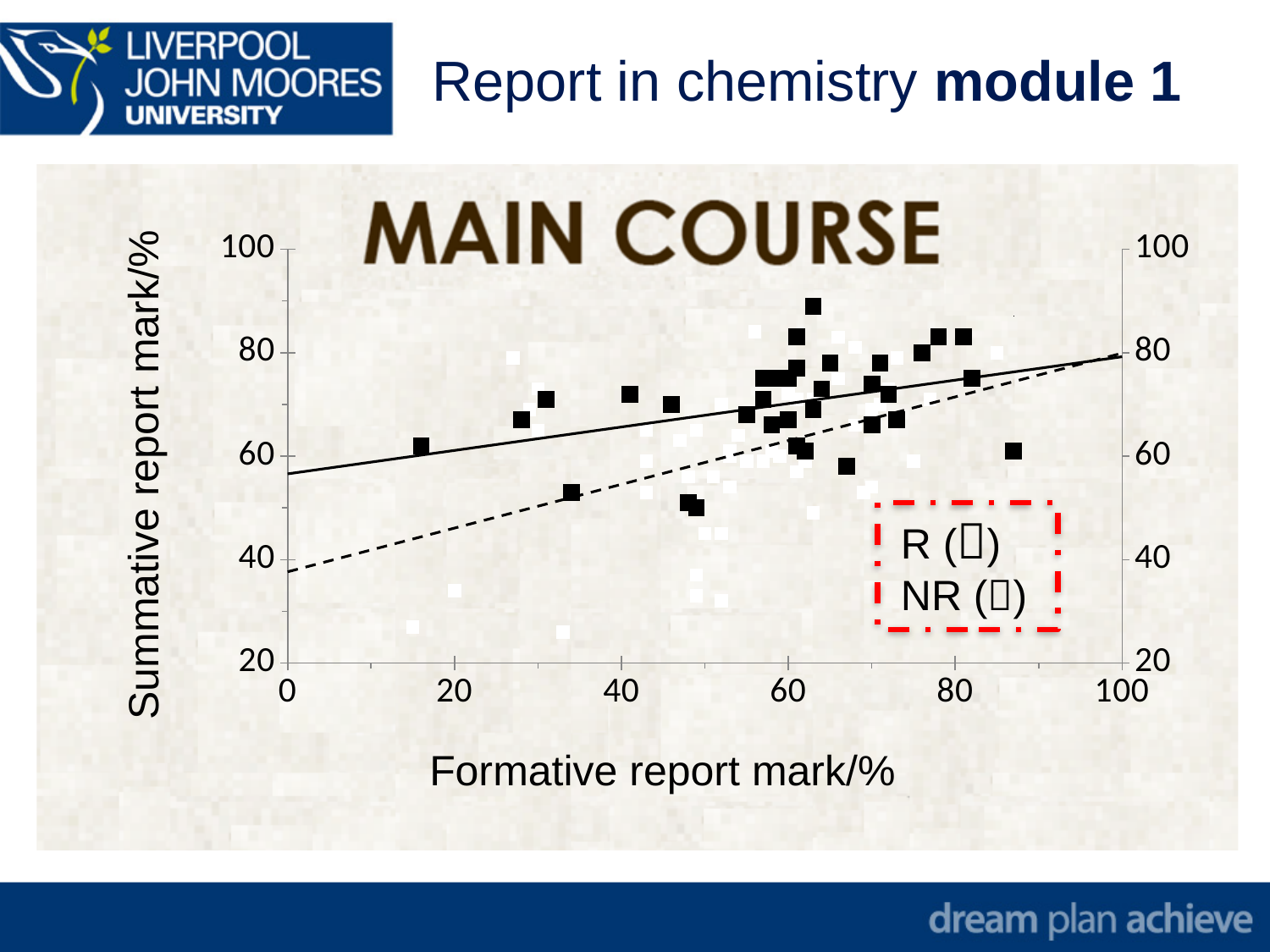
What kind of chart is shown on the slide? scatter chart Do the fitted trend lines rise or fall as the formative report mark increases? rise Is the value of the dashed trend line at a formative mark of 0 greater or less than 60? less What are the two series named in the legend? R and NR What is the lowest value shown on the y axis? 20 What is the title printed above the chart? MAIN COURSE What is the label of the x axis? Formative report mark/% Is the value of the solid trend line at a formative mark of 100 greater or less than 60? greater What is the label of the y axis? Summative report mark/% Is the value of the solid trend line at a formative mark of 0 greater or less than 40? greater How many series does the legend list? 2 What is the highest value shown on the x axis? 100